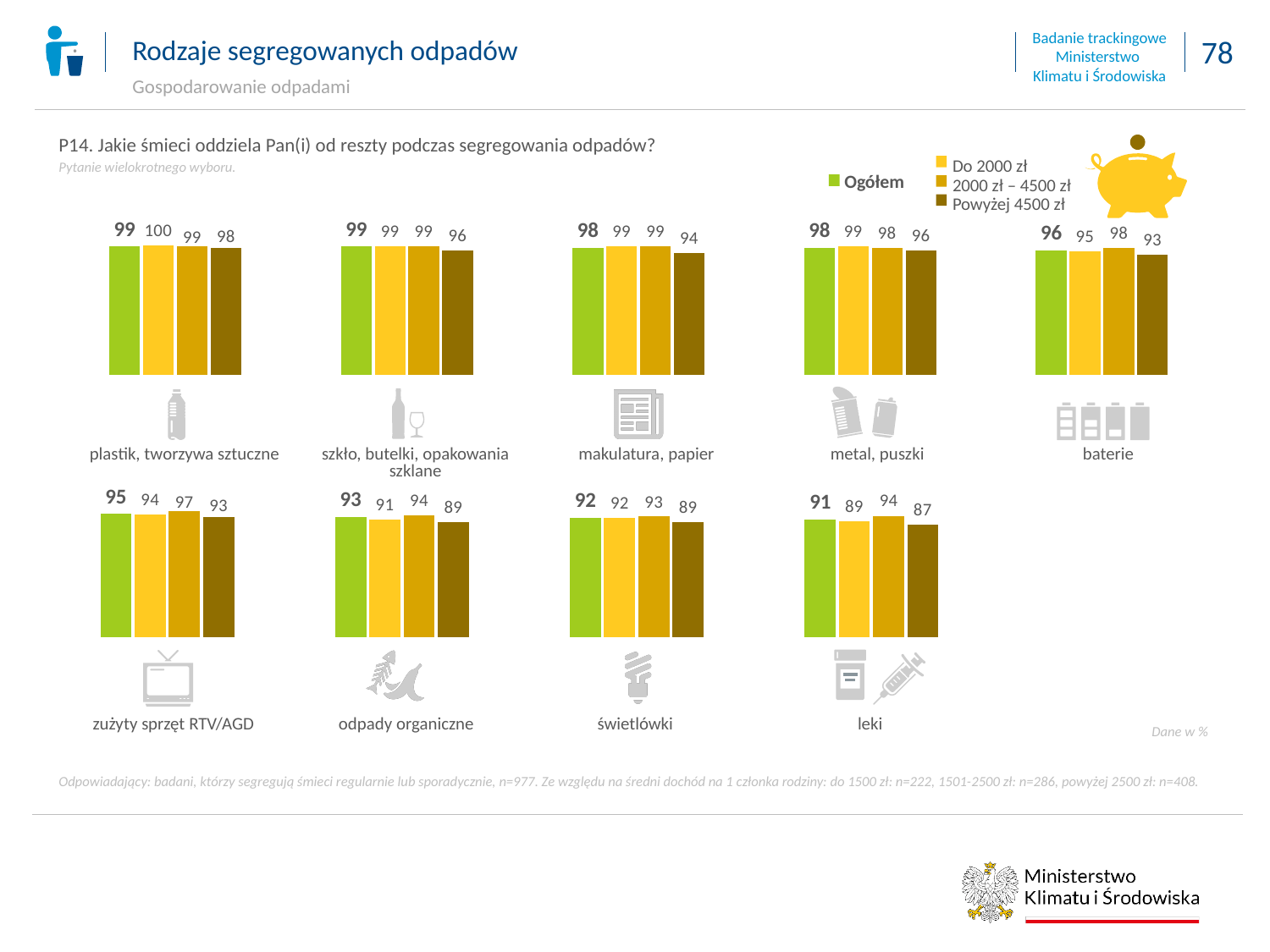
In the chart for 'leki', what is the value for 'Powyżej 4500 zł'? 87 How many waste categories (small charts) are shown on the slide? 9 Which is larger: the 'Ogółem' value for 'zużyty sprzęt RTV/AGD' or the 'Ogółem' value for 'leki'? zużyty sprzęt RTV/AGD In the chart for 'odpady organiczne', which income group has the lowest value? Powyżej 4500 zł In the chart for 'świetlówki', what is the difference between the 'Ogółem' value and the 'Powyżej 4500 zł' value? 3 In the chart for 'makulatura, papier', what is the difference between the 'Do 2000 zł' value and the 'Powyżej 4500 zł' value? 5 In the chart for 'plastik, tworzywa sztuczne', what is the value for 'Do 2000 zł'? 100 In the chart for 'baterie', what is the value for '2000 zł – 4500 zł'? 98 In the chart for 'leki', which income group has the highest value? 2000 zł – 4500 zł What kind of chart is used for each waste category on the slide? Bar chart How many series does the legend list? 4 In the chart for 'plastik, tworzywa sztuczne', what is the value for 'Ogółem'? 99